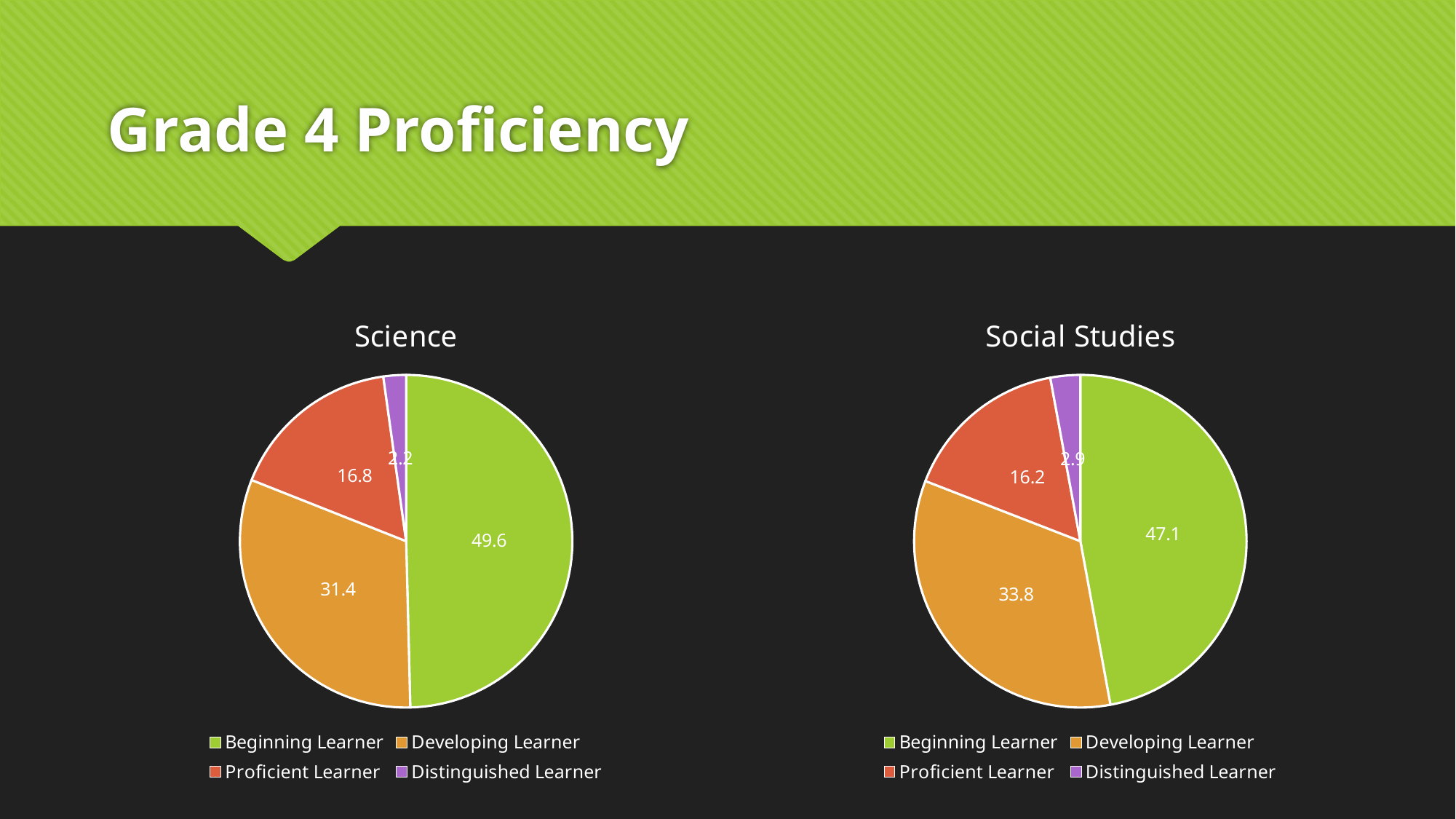
In the Science chart, what is the difference between the Developing Learner and Proficient Learner values? 14.6 In the Social Studies chart, which category has the smallest slice? Distinguished Learner In the Science chart, what is the value for Distinguished Learner? 2.2 In the Social Studies chart, what is the difference between the Distinguished Learner value and the Science chart's Distinguished Learner value? 0.7 In the Social Studies chart, what is the value for Developing Learner? 33.8 What colour is the Proficient Learner slice in the Science chart? Red What kind of chart is the Science chart? Pie chart In the Science chart, what is the value for Beginning Learner? 49.6 In the Social Studies chart, what is the value for Proficient Learner? 16.2 How many slices does the Social Studies chart have? 4 Which is larger: the Beginning Learner value in the Science chart or the Beginning Learner value in the Social Studies chart? Science In the Science chart, which category has the largest slice? Beginning Learner